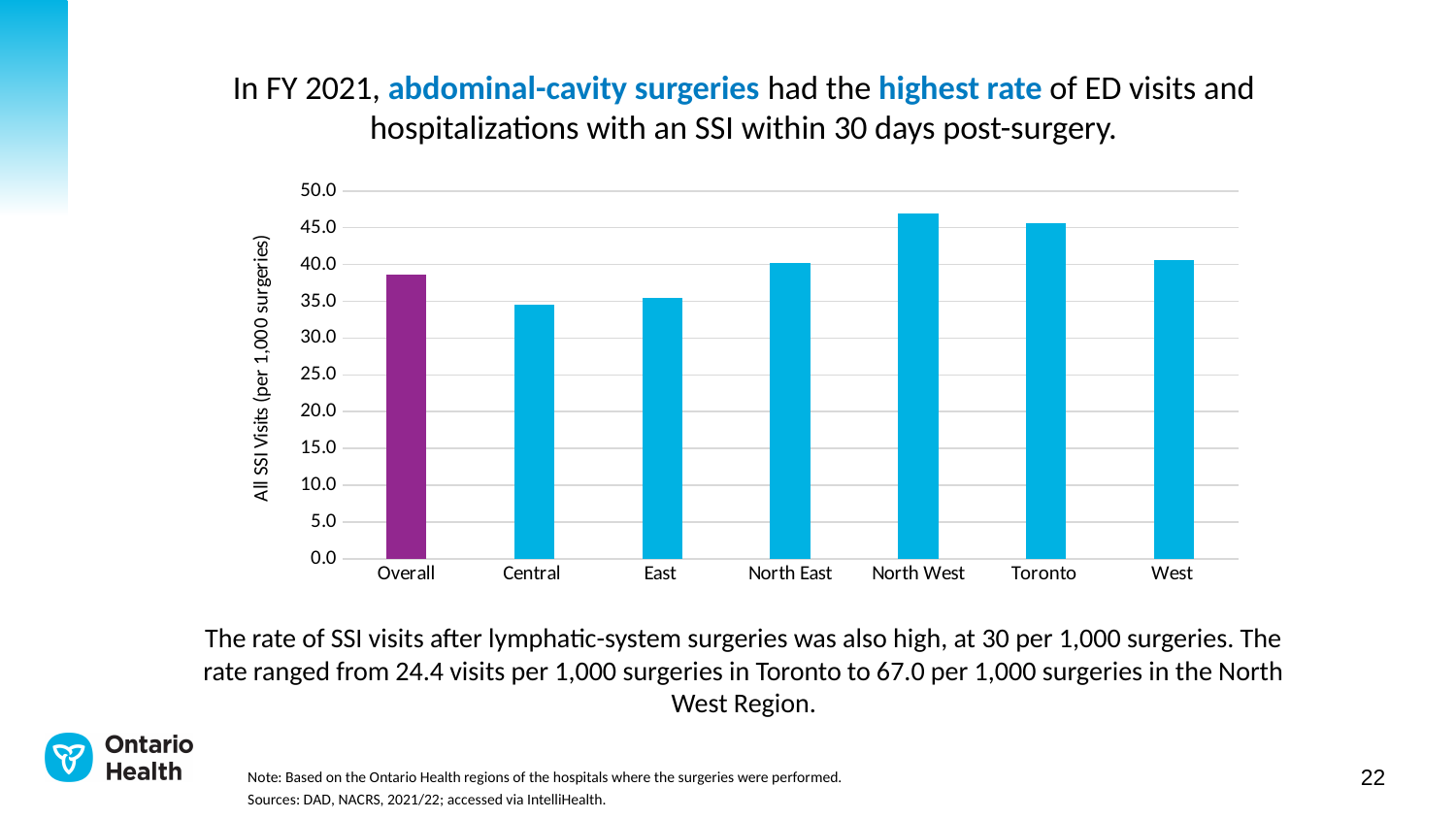
Is the value for North West greater or less than 45.0? greater Is the value for Overall greater or less than 35.0? greater What is the label on the y axis of the chart? All SSI Visits (per 1,000 surgeries) Which region has the lowest rate of SSI visits in the chart? Central What kind of chart is shown on the slide? bar chart How many categories are shown on the x axis of the chart? 7 Which region has the highest rate of SSI visits in the chart? North West Is the value for East greater or less than 40.0? less Which is larger, the value for North East or the value for Central? North East Which is larger, the value for Toronto or the value for West? Toronto